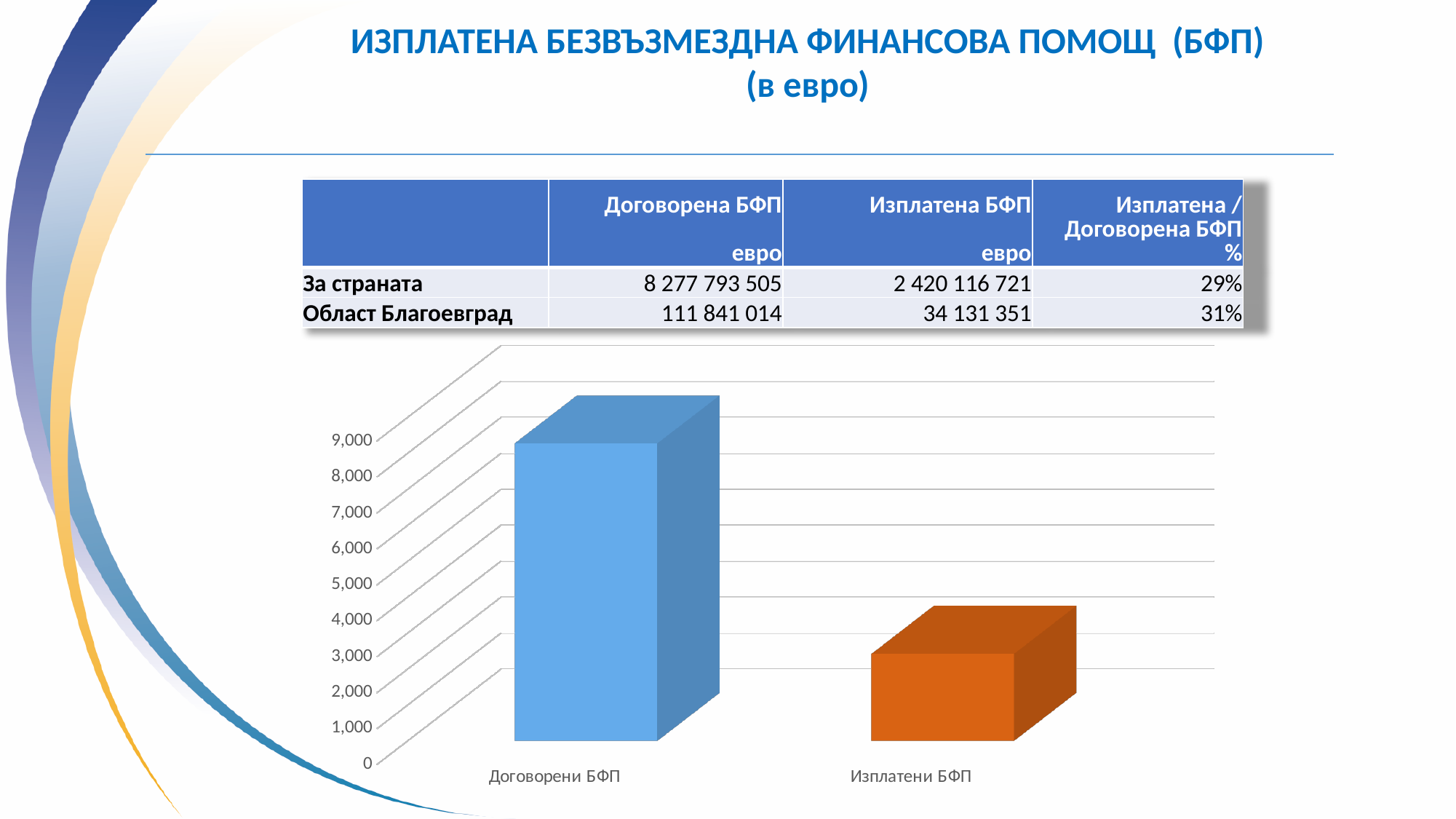
How many bars are plotted in the chart? 2 Which bar is taller, Договорени БФП or Изплатени БФП? Договорени БФП Is the value for Изплатени БФП greater or less than 1,000? greater What is the highest tick value shown on the vertical axis of the chart? 9,000 Which category has the lowest bar in the chart? Изплатени БФП Is the value for Договорени БФП greater or less than 7,000? greater Is the value for Изплатени БФП greater or less than 5,000? less What colour is the bar for Изплатени БФП? orange What kind of chart is shown on the slide? bar chart Which category has the highest bar in the chart? Договорени БФП